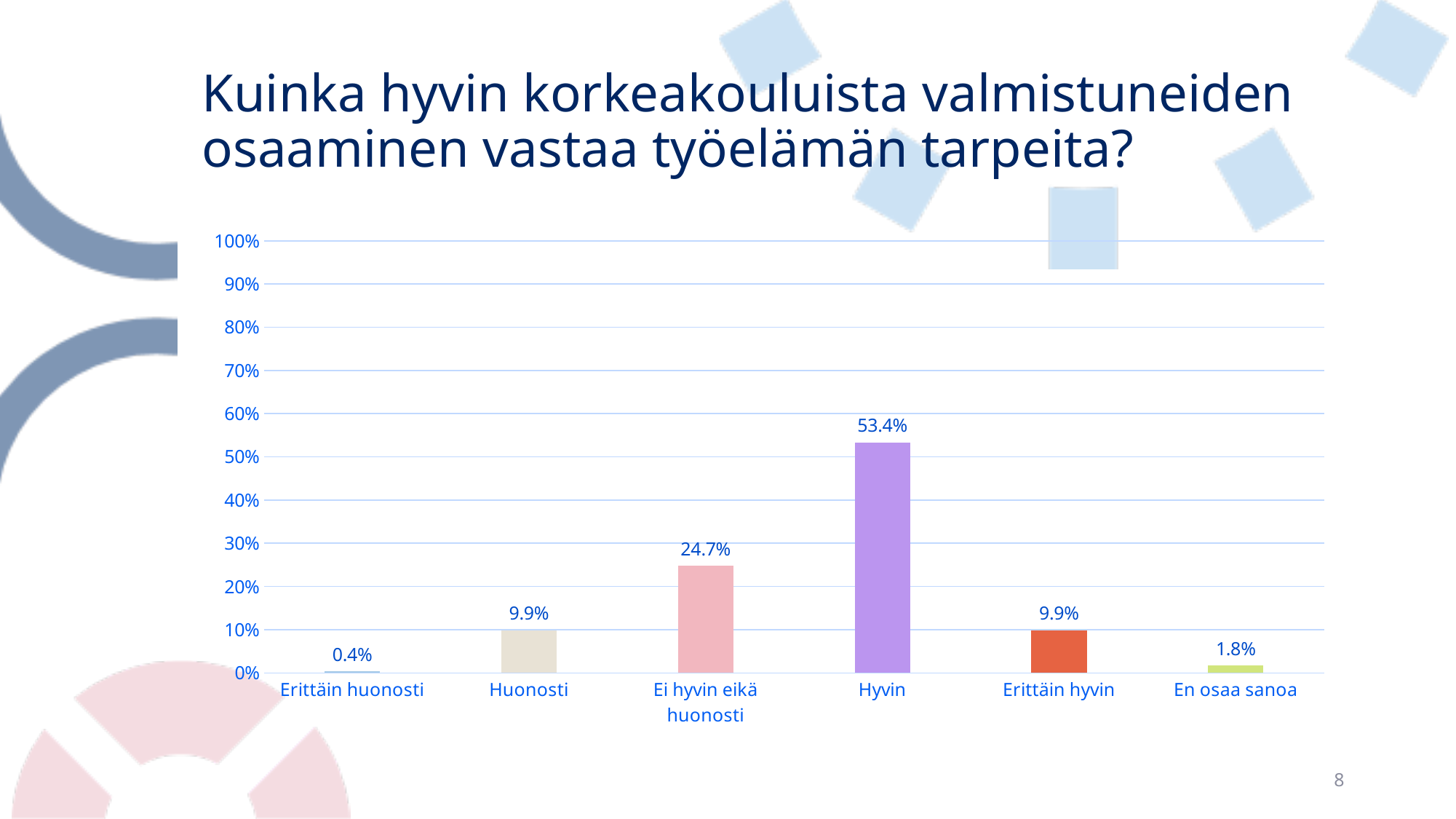
Is the value for Hyvin greater or less than 50%? greater Which is larger, the value for Huonosti or the value for En osaa sanoa? Huonosti Which category has the lowest value? Erittäin huonosti What is the value for Hyvin? 53.4% What kind of chart is shown on the slide? Bar chart What is the value for Ei hyvin eikä huonosti? 24.7% How many categories are shown on the x axis? 6 Which category has the highest value? Hyvin What is the difference between the values for Hyvin and Ei hyvin eikä huonosti? 28.7% What is the value for Erittäin huonosti? 0.4% What is the value for En osaa sanoa? 1.8% What is the title of the slide? Kuinka hyvin korkeakouluista valmistuneiden osaaminen vastaa työelämän tarpeita?